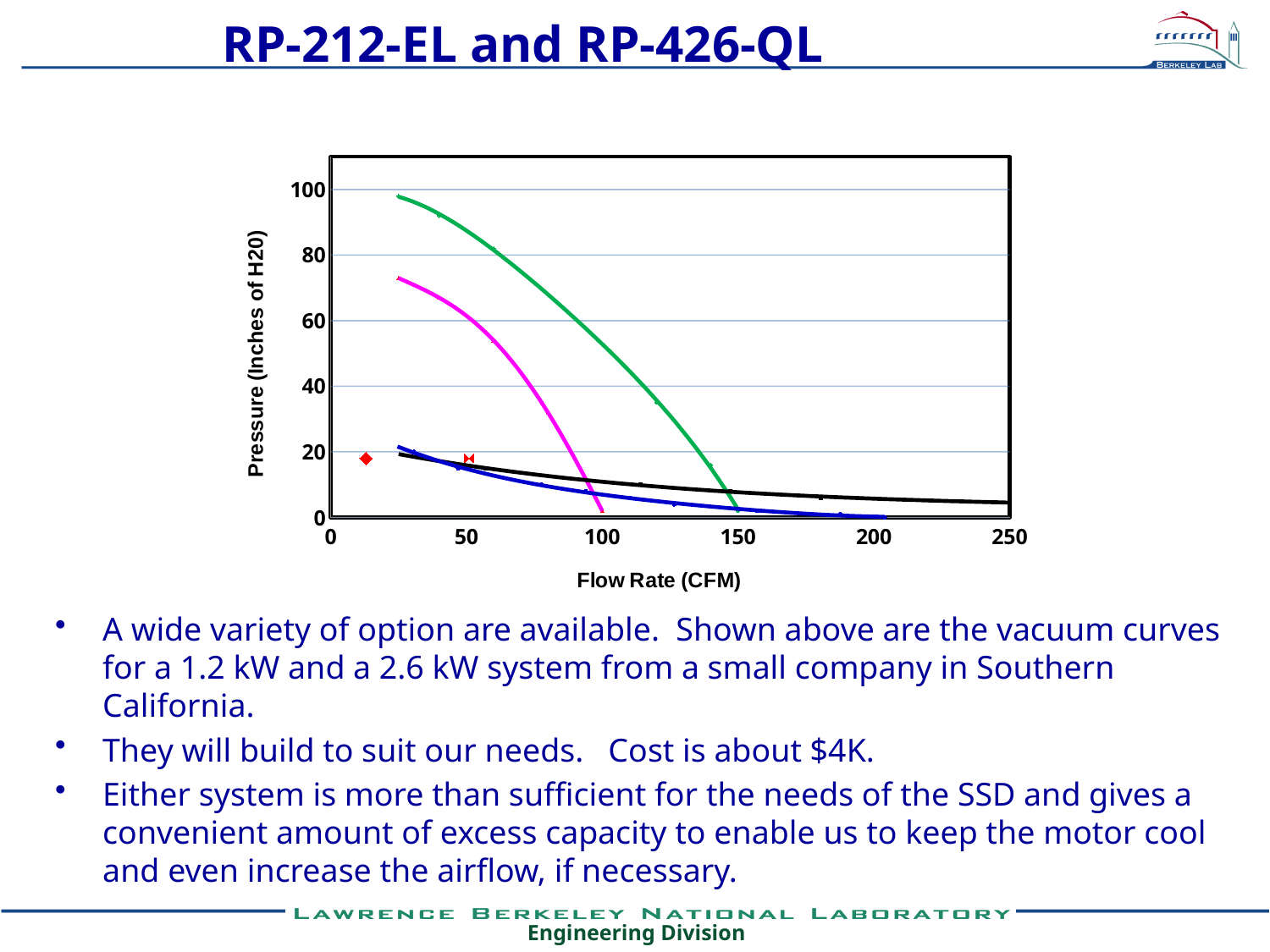
Do the curves on the chart rise or fall as flow rate increases? fall Is the pressure of the black curve at a flow rate of 100 CFM greater or less than 20? less Is the pressure of the green curve at a flow rate of 50 CFM greater or less than 80? greater How many curves are plotted on the chart? 4 Is the pressure of the magenta curve at a flow rate of 50 CFM greater or less than 80? less What kind of chart is shown on the slide? line chart What is the highest value shown on the y axis of the chart? 100 What is the title of the x axis of the chart? Flow Rate (CFM) At a flow rate of 100 CFM, which curve shows the higher pressure, the green curve or the blue curve? green curve What is the highest value shown on the x axis of the chart? 250 What is the title of the y axis of the chart? Pressure (Inches of H20)